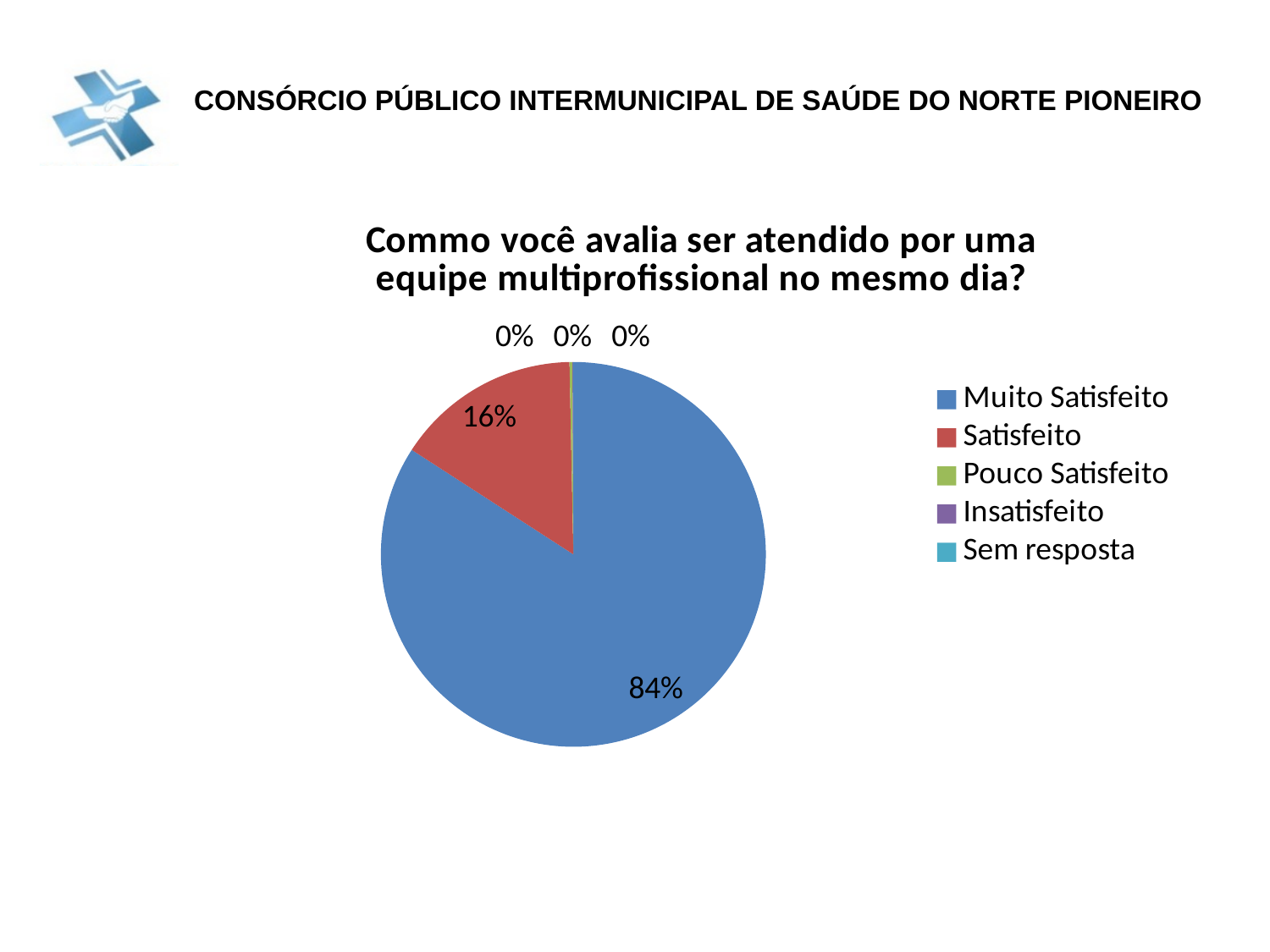
What is the difference in percentage points between Muito Satisfeito and Satisfeito? 68 What colour is the slice for Satisfeito? red How many categories does the legend list? 5 What share of the pie does Muito Satisfeito have? 84% Which category has the largest slice of the pie? Muito Satisfeito How many categories are labelled 0% on the chart? 3 What share of the pie does Satisfeito have? 16% What is the title of the chart? Commo você avalia ser atendido por uma equipe multiprofissional no mesmo dia? What kind of chart is shown on the slide? pie chart Which is larger, the share for Muito Satisfeito or the share for Satisfeito? Muito Satisfeito What percentage is shown for Pouco Satisfeito? 0%